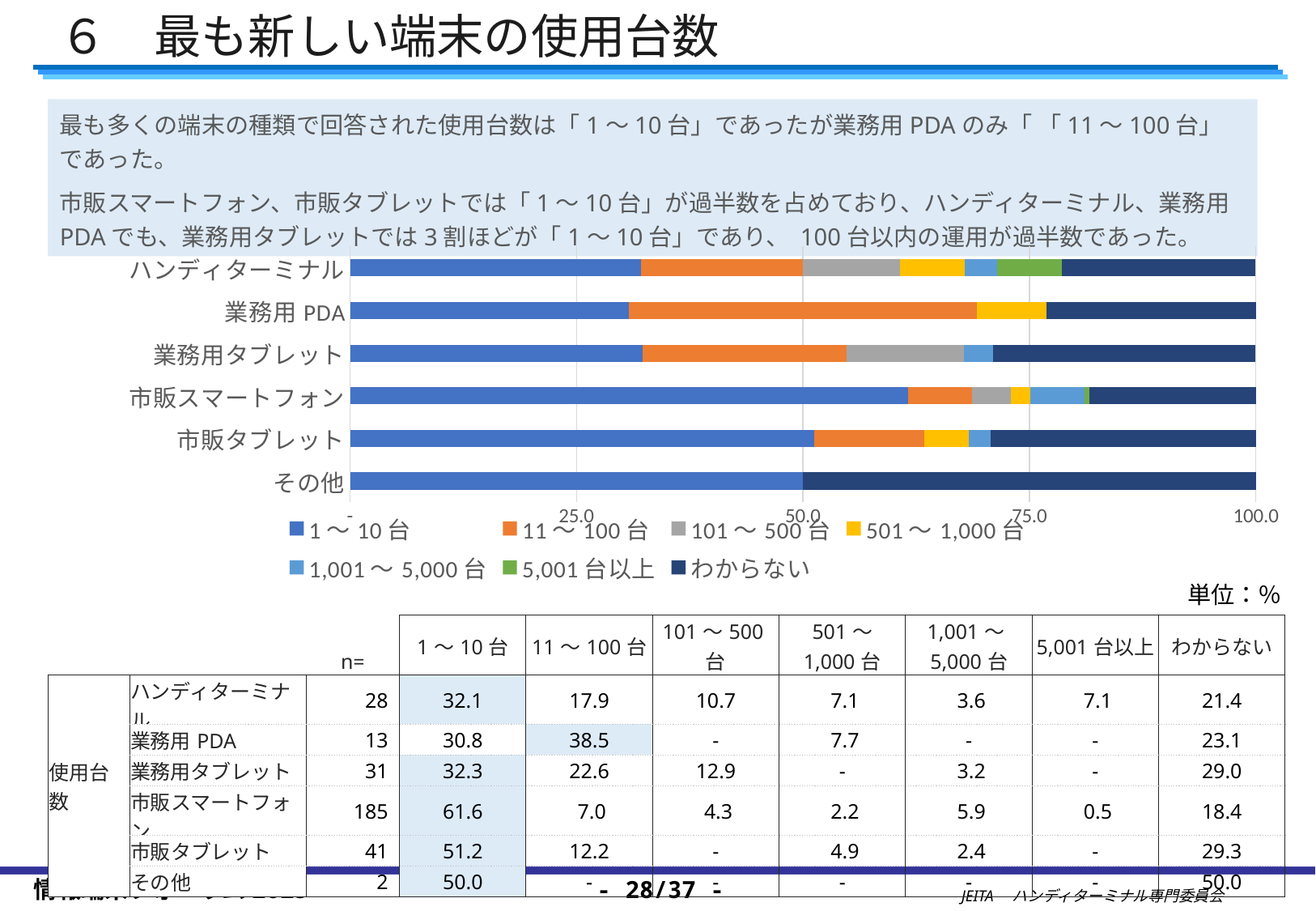
What is the difference between the 1～10台 value and the 11～100台 value for 市販タブレット? 39.0 How many series does the chart legend list? 7 What kind of chart is shown on the slide? Stacked bar chart Is the 1～10台 value for 市販スマートフォン greater or less than 50.0? greater Which category has the lowest value for わからない? 市販スマートフォン What is the maximum value shown on the chart's horizontal axis? 100.0 What is the value of 11～100台 for 業務用PDA? 38.5 Which is larger: the わからない value for ハンディターミナル or for 業務用タブレット? 業務用タブレット What is the value of わからない for その他? 50.0 Which category has the highest value for 1～10台? 市販スマートフォン How many device categories are plotted on the chart? 6 What is the value of 1～10台 for 市販スマートフォン? 61.6